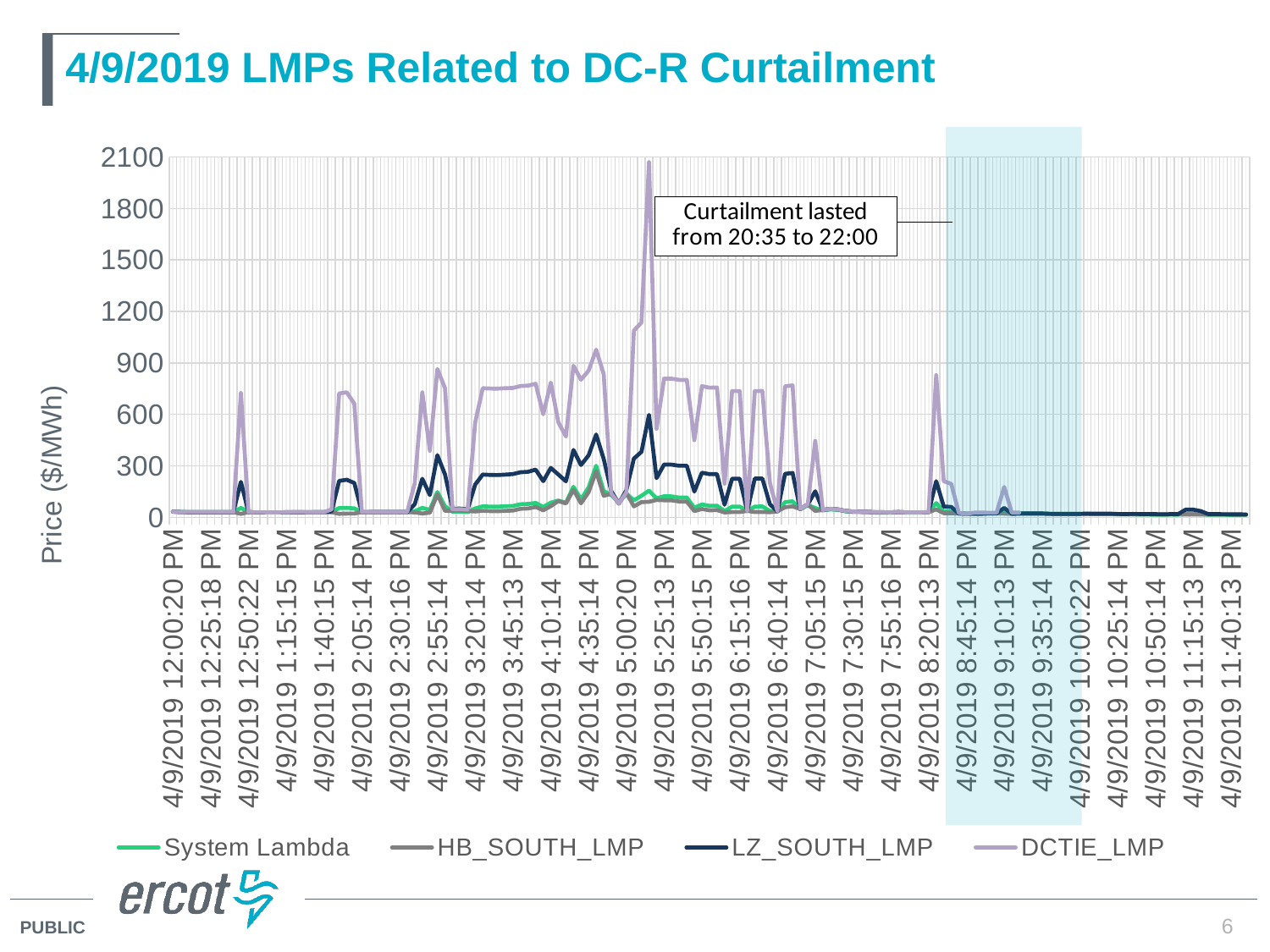
Which series reaches the highest value on the chart? DCTIE_LMP Which series has the higher peak, DCTIE_LMP or LZ_SOUTH_LMP? DCTIE_LMP What is the title of the chart on the slide? 4/9/2019 LMPs Related to DC-R Curtailment Is the peak value of LZ_SOUTH_LMP greater or less than 900? less According to the annotation on the chart, during what time period did the curtailment last? from 20:35 to 22:00 Is the peak value of DCTIE_LMP greater or less than 1800? greater Is the peak value of System Lambda greater or less than 600? less Do the prices generally rise or fall after the shaded curtailment period begins around 8:45 PM? fall Which series has the higher peak, LZ_SOUTH_LMP or HB_SOUTH_LMP? LZ_SOUTH_LMP How many series does the legend list? 4 What kind of chart is shown on the slide? line chart